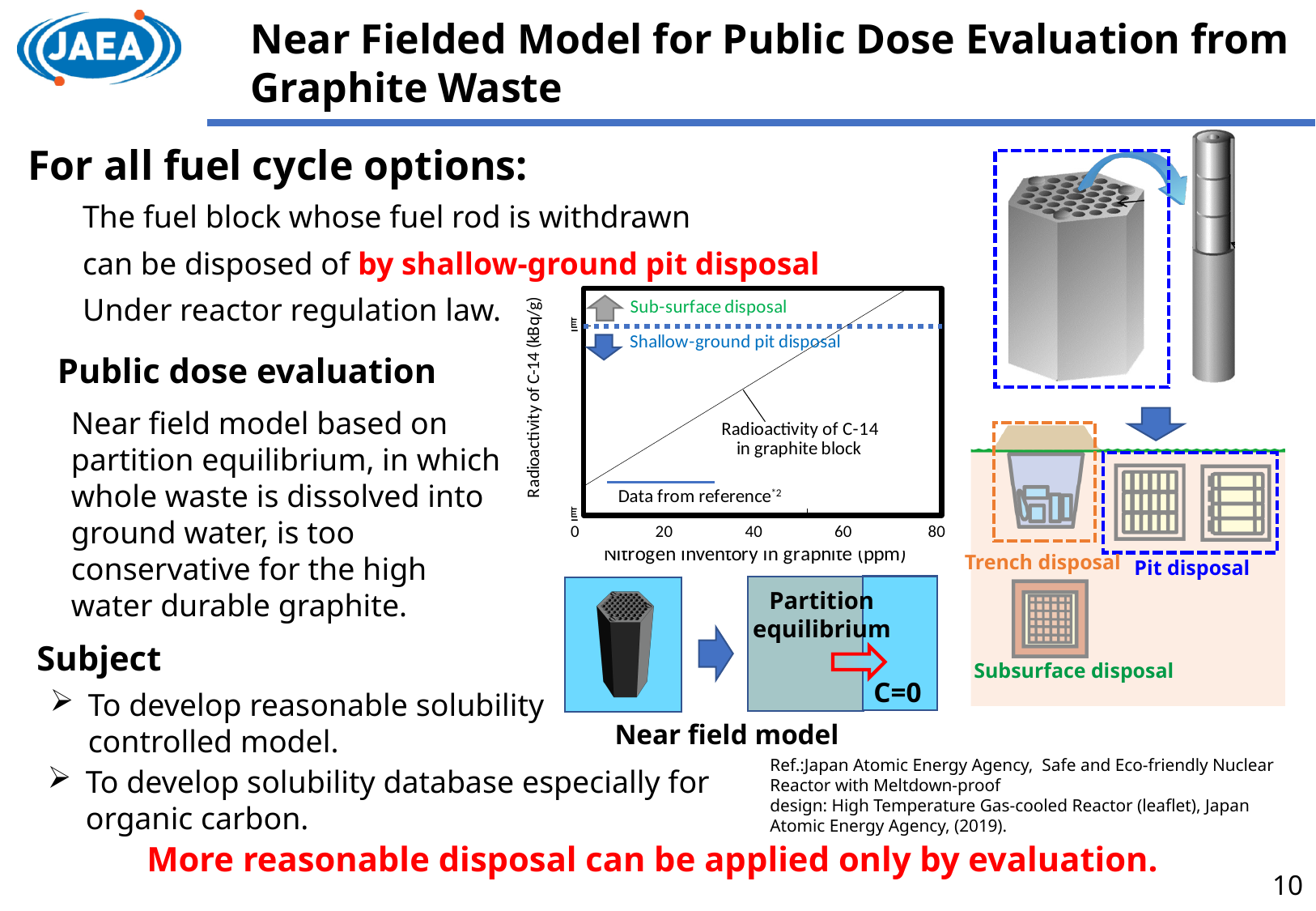
What kind of chart is shown on the slide? line chart What is the label of the x axis of the chart? Nitrogen inventory in graphite (ppm) How many tick values are printed on the x axis of the chart? 5 Does the radioactivity of C-14 in graphite block rise or fall as the nitrogen inventory in graphite increases? rise What is the interval between consecutive tick values on the x axis of the chart? 20 What is the lowest tick value shown on the x axis of the chart? 0 What is the highest tick value shown on the x axis of the chart? 80 What is the label of the y axis of the chart? Radioactivity of C-14 (kBq/g)